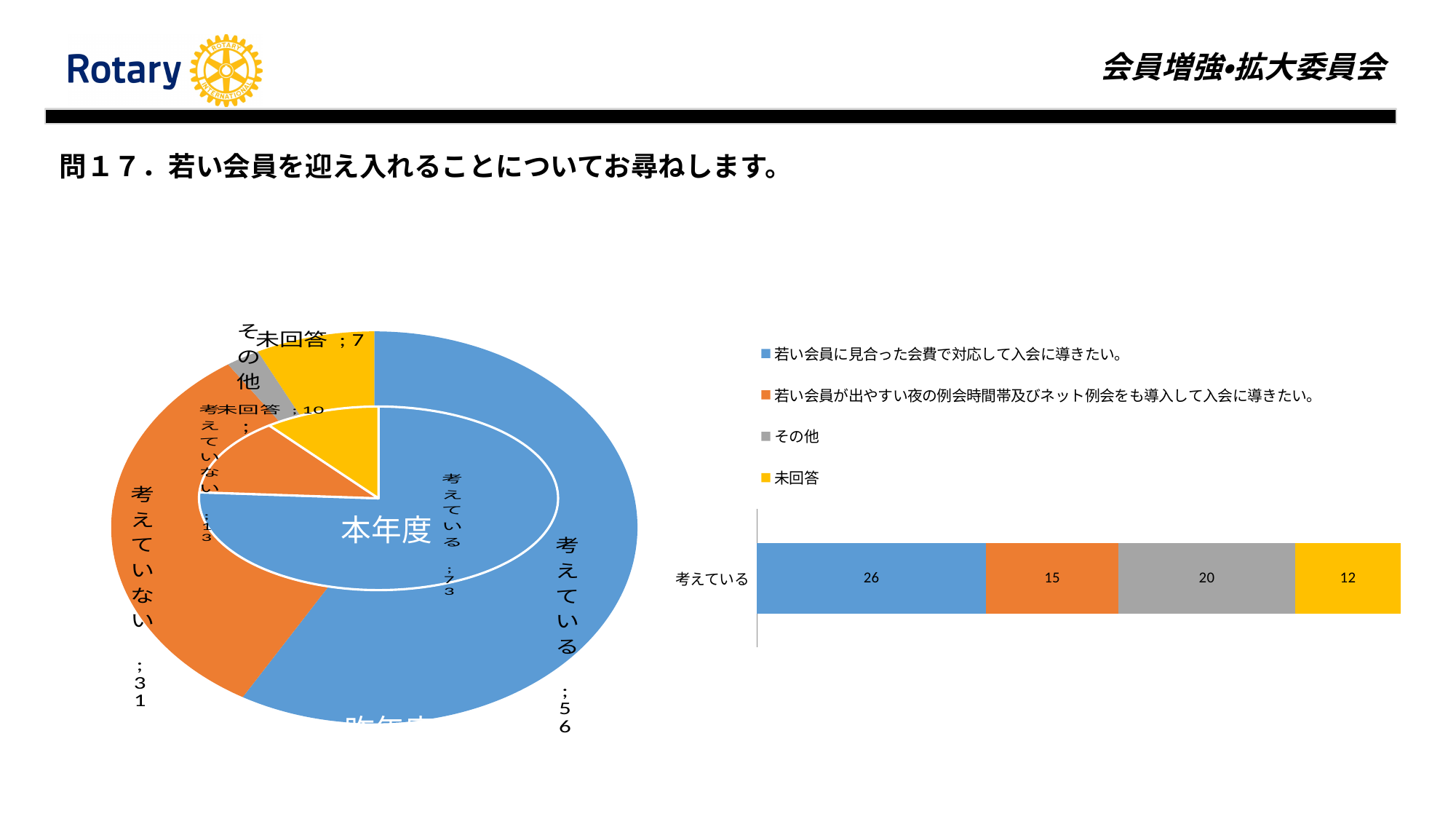
In the bar chart on the right, what is the value for その他? 20 In the pie chart on the left, what is the value labelled for 考えていない in the outer 昨年度 ring? 31 In the bar chart on the right, how many series does the legend list? 4 In the bar chart on the right, what is the value for 未回答? 12 What kind of chart is the chart on the left side of the slide? pie chart In the bar chart on the right, which series has the largest value? 若い会員に見合った会費で対応して入会に導きたい。 What kind of chart is the chart on the right side of the slide? bar chart In the bar chart on the right, which series has the smallest value? 未回答 In the bar chart on the right, what is the value for 若い会員に見合った会費で対応して入会に導きたい。? 26 In the bar chart on the right, what is the total of the stacked bar for 考えている? 73 In the pie chart on the left, what is the value labelled for 考えている in the outer 昨年度 ring? 56 In the bar chart on the right, what is the difference between the value for 若い会員に見合った会費で対応して入会に導きたい。 and the value for 若い会員が出やすい夜の例会時間帯及びネット例会をも導入して入会に導きたい。? 11